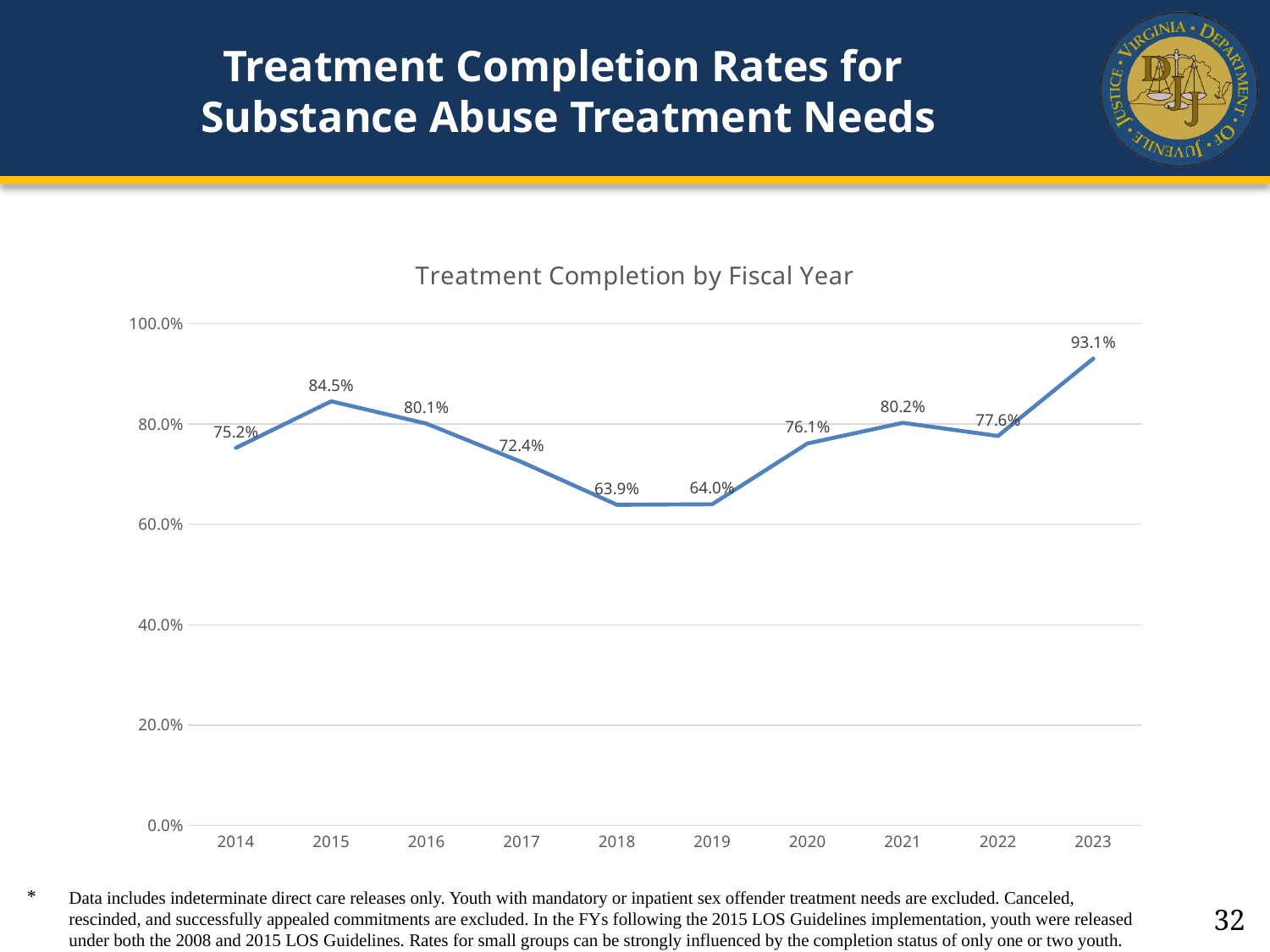
Is the treatment completion rate for 2017 greater or less than 80.0%? less What is the difference between the treatment completion rates for 2015 and 2014? 9.3% What is the title of the chart? Treatment Completion by Fiscal Year What is the treatment completion rate for fiscal year 2015? 84.5% What kind of chart is shown on the slide? line chart What is the treatment completion rate for fiscal year 2018? 63.9% Which fiscal year has the lowest treatment completion rate? 2018 Which fiscal year has a higher treatment completion rate, 2016 or 2021? 2021 What is the treatment completion rate for fiscal year 2023? 93.1% Which fiscal year has the highest treatment completion rate? 2023 What is the difference between the treatment completion rates for 2023 and 2022? 15.5% How many fiscal years are plotted on the chart? 10